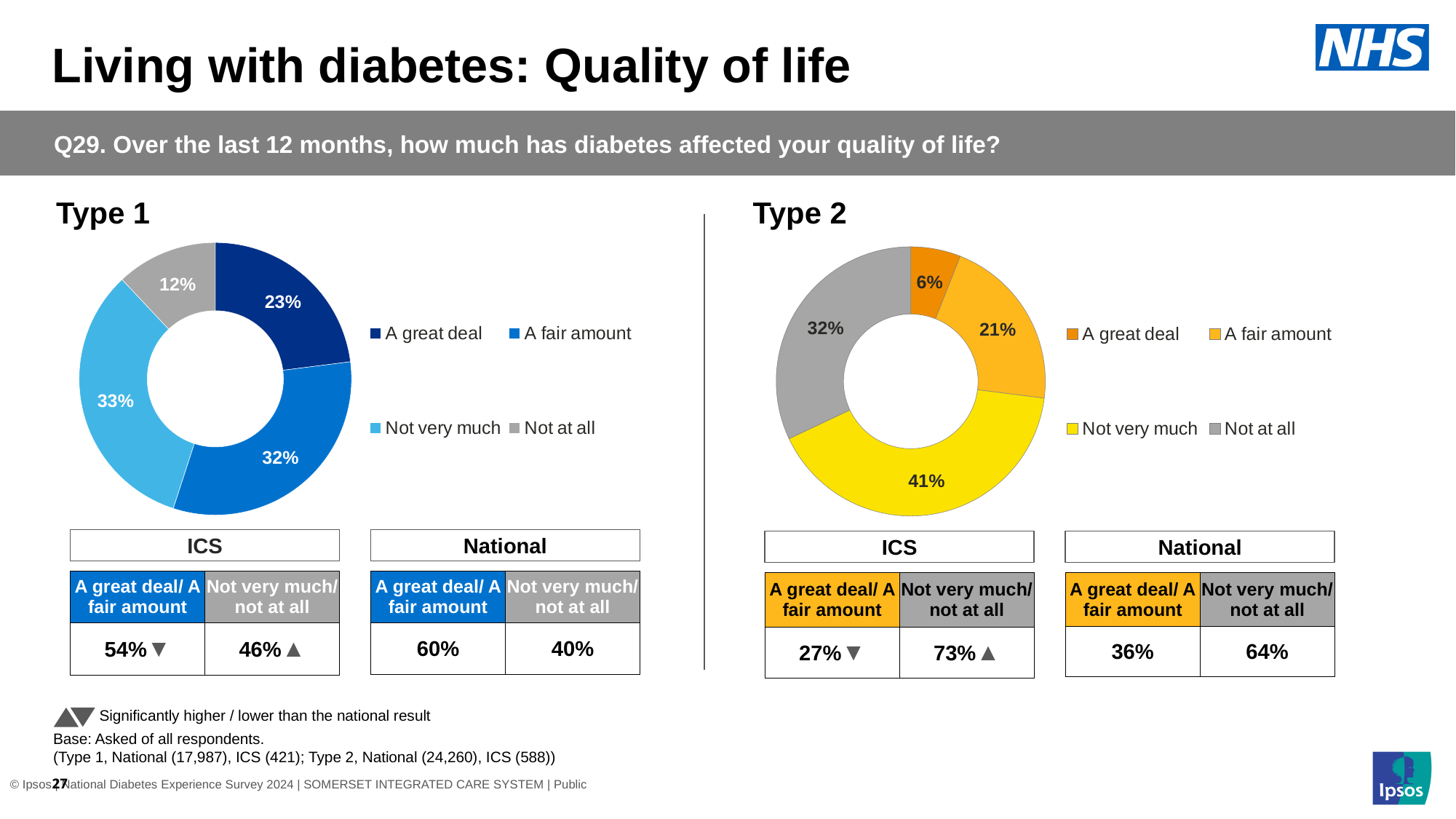
In the Type 1 chart, what percentage of respondents said diabetes affected their quality of life 'A great deal'? 23% In the Type 2 chart, what is the difference between 'Not very much' and 'A fair amount'? 20 percentage points In the Type 2 chart, which category has the smallest share? A great deal In the Type 2 chart, which category has the largest share? Not very much In the Type 1 chart, which category has the smallest share? Not at all What type of chart is used for Type 2? Doughnut (pie) chart In the Type 1 chart, what is the difference between 'A fair amount' and 'Not at all'? 20 percentage points How many categories does the Type 1 chart show? 4 In the Type 2 chart, what is the value for 'Not very much'? 41% In the Type 2 chart, what percentage said 'A great deal'? 6% In the Type 1 chart, what is the value for 'Not at all'? 12% Which is larger in the Type 2 chart: 'Not at all' or 'A fair amount'? Not at all